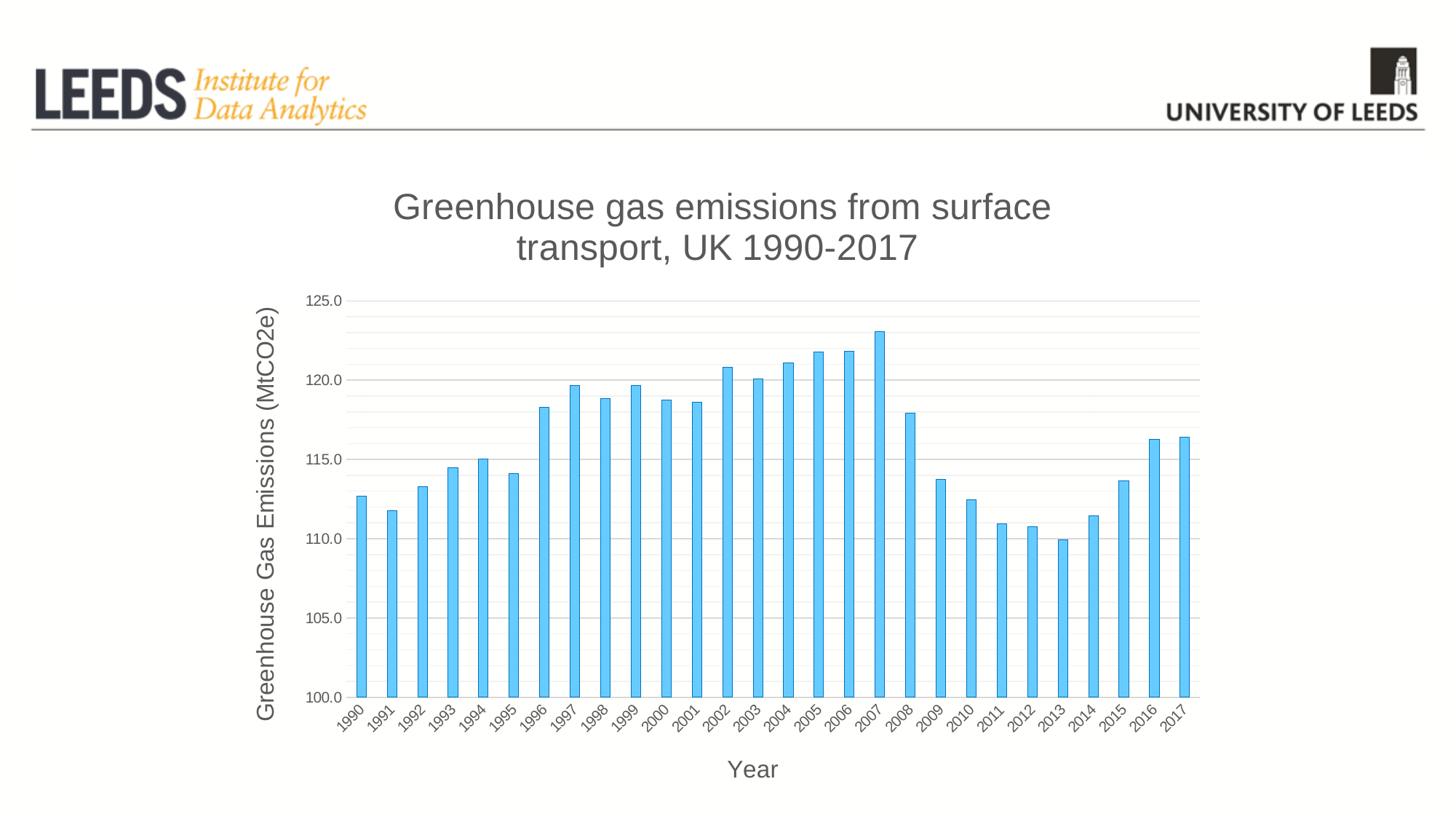
What kind of chart is shown on the slide? Bar chart Which year has the lowest greenhouse gas emissions from surface transport? 2013 Do emissions generally rise or fall from 2007 to 2013? Fall How many years are plotted on the chart? 28 Which year has higher emissions, 2016 or 2010? 2016 Which year has higher emissions, 1996 or 1995? 1996 Is the value for 2007 greater or less than 120.0? greater What is the label on the vertical axis of the chart? Greenhouse Gas Emissions (MtCO2e) Is the value for 2002 greater or less than 120.0? greater Which year has the highest greenhouse gas emissions from surface transport? 2007 Is the value for 1990 greater or less than 115.0? less